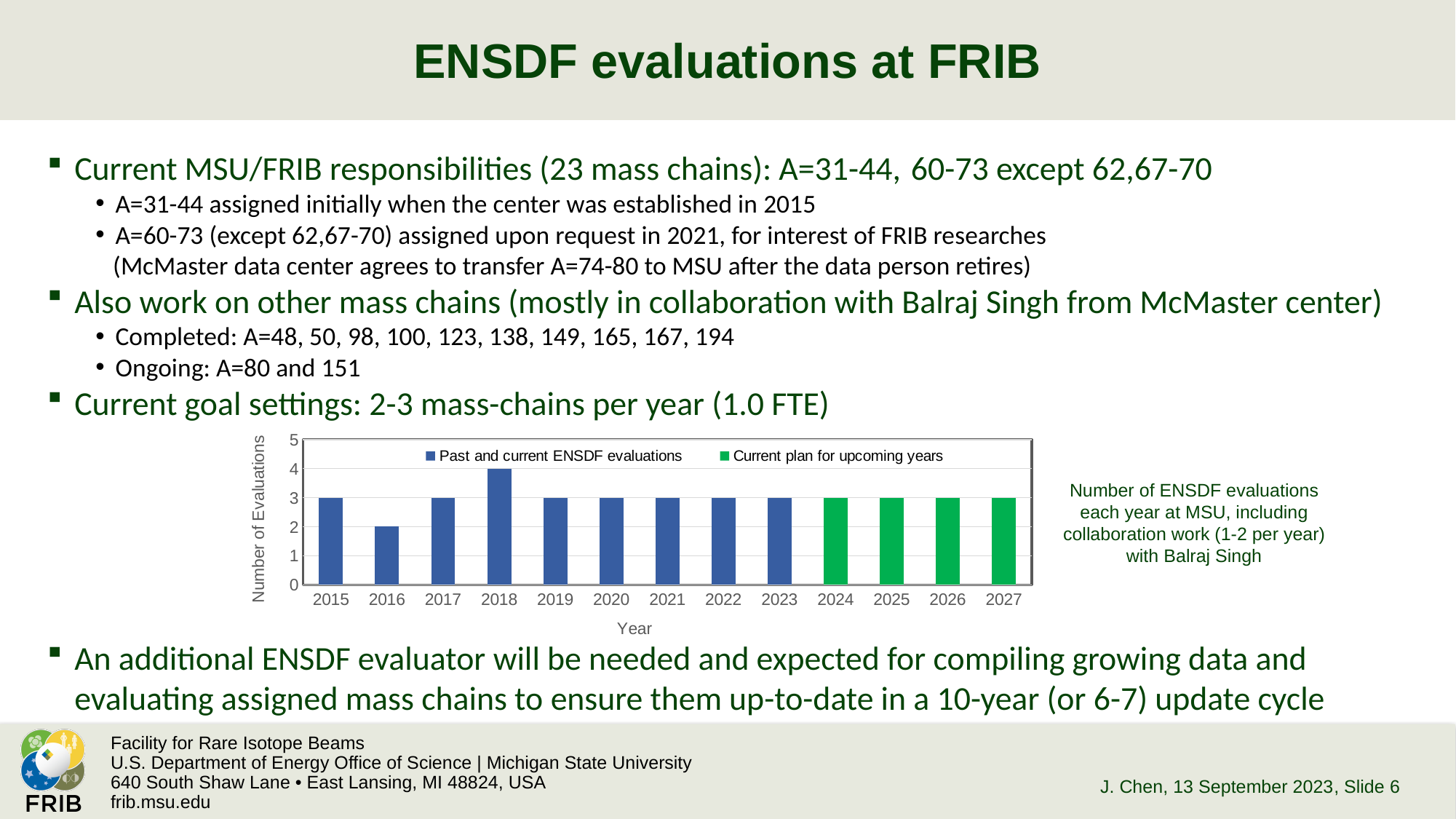
Which year has more evaluations, 2017 or 2018? 2018 How many years are shown on the x axis of the chart? 13 What is the number of evaluations for 2016? 2 Which year has the lowest number of evaluations? 2016 Which legend entry is shown in green? Current plan for upcoming years What is the number of evaluations planned for 2025? 3 What is the number of evaluations for 2018? 4 What is the label of the y axis of the chart? Number of Evaluations What is the difference between the number of evaluations in 2018 and in 2016? 2 What kind of chart is shown on the slide? bar chart How many series does the chart legend list? 2 Which year has the highest number of evaluations? 2018